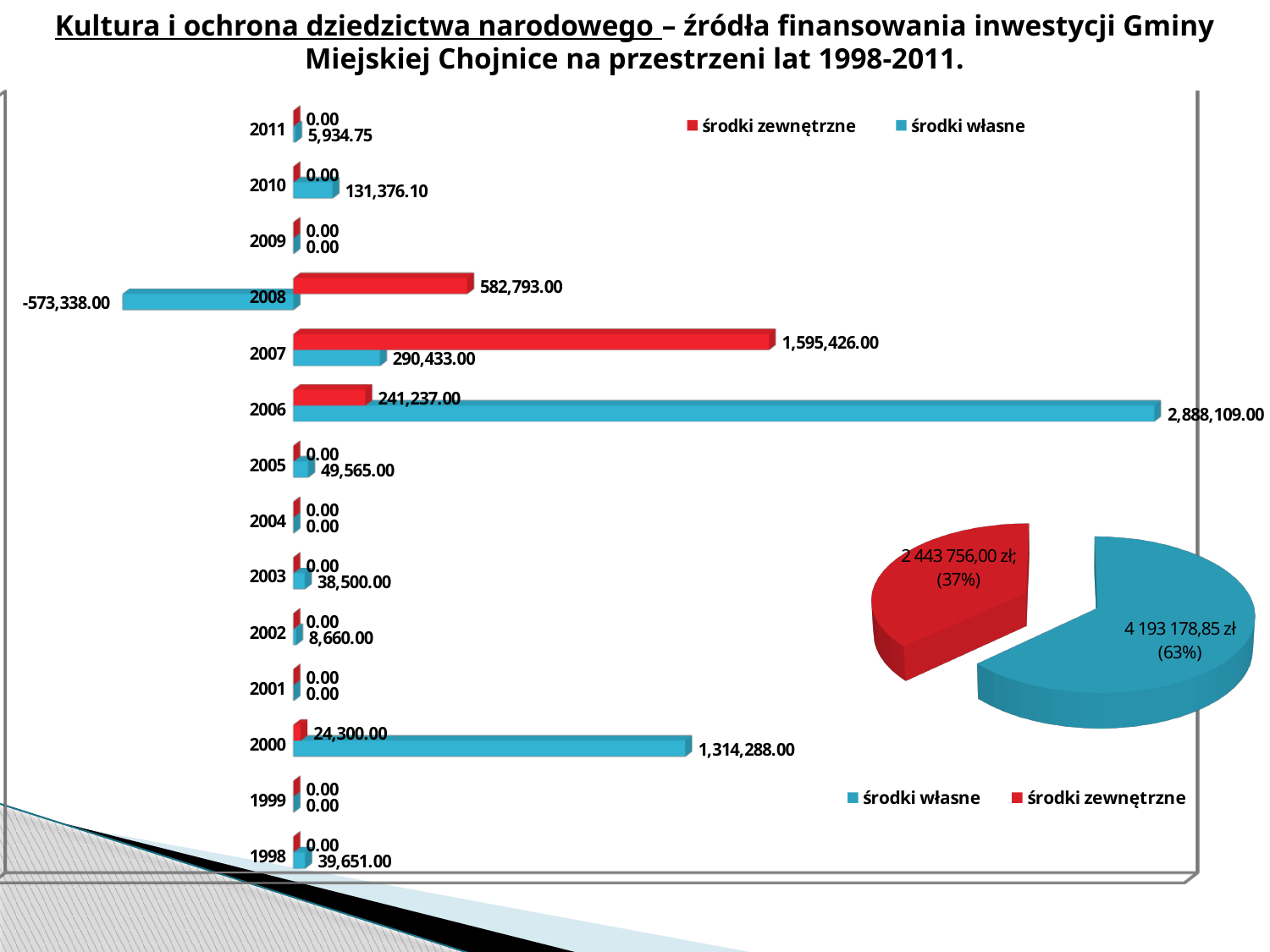
How many years are shown in the bar chart? 14 In the bar chart, which year has the highest value of środki własne? 2006 How many series does the legend of the bar chart list? 2 In the bar chart, which year has the highest value of środki zewnętrzne? 2007 In the bar chart, what is the value of środki zewnętrzne for 2007? 1,595,426.00 In the pie chart, what share does środki własne have? 63% In the bar chart, what is the value of środki własne for 2008? -573,338.00 In the bar chart, what is the value of środki własne for 2006? 2,888,109.00 What kind of chart is the chart on the left of the slide? bar chart In the bar chart, which year has the lowest value of środki własne? 2008 In the bar chart, which is larger in 2006: środki zewnętrzne or środki własne? środki własne In the bar chart, what is the difference between środki zewnętrzne and środki własne in 2007? 1,304,993.00